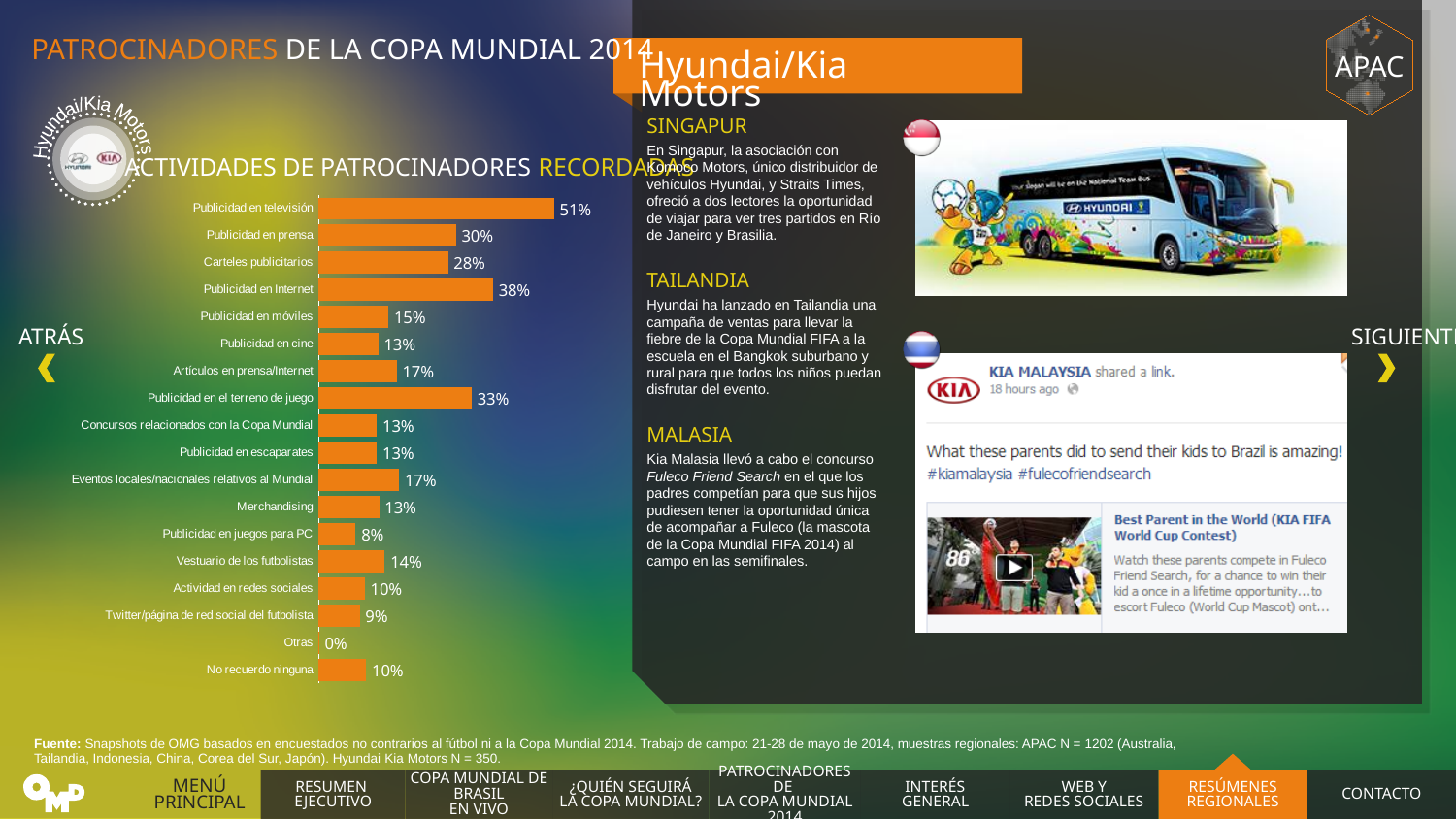
Which is larger, Carteles publicitarios or Publicidad en móviles? Carteles publicitarios Which category has the lowest value in the chart? Otras What percentage is shown for Publicidad en televisión? 51% What is the value for Publicidad en juegos para PC? 8% What is the value for Publicidad en Internet? 38% What is the difference between Vestuario de los futbolistas and Twitter/página de red social del futbolista? 5 percentage points What percentage is shown for No recuerdo ninguna? 10% Which category has the highest value in the chart? Publicidad en televisión What percentage is shown for Publicidad en el terreno de juego? 33% What is the difference between Publicidad en televisión and Publicidad en prensa? 21 percentage points How many categories are shown in the bar chart? 18 What type of chart is used to show the recalled sponsor activities? Bar chart